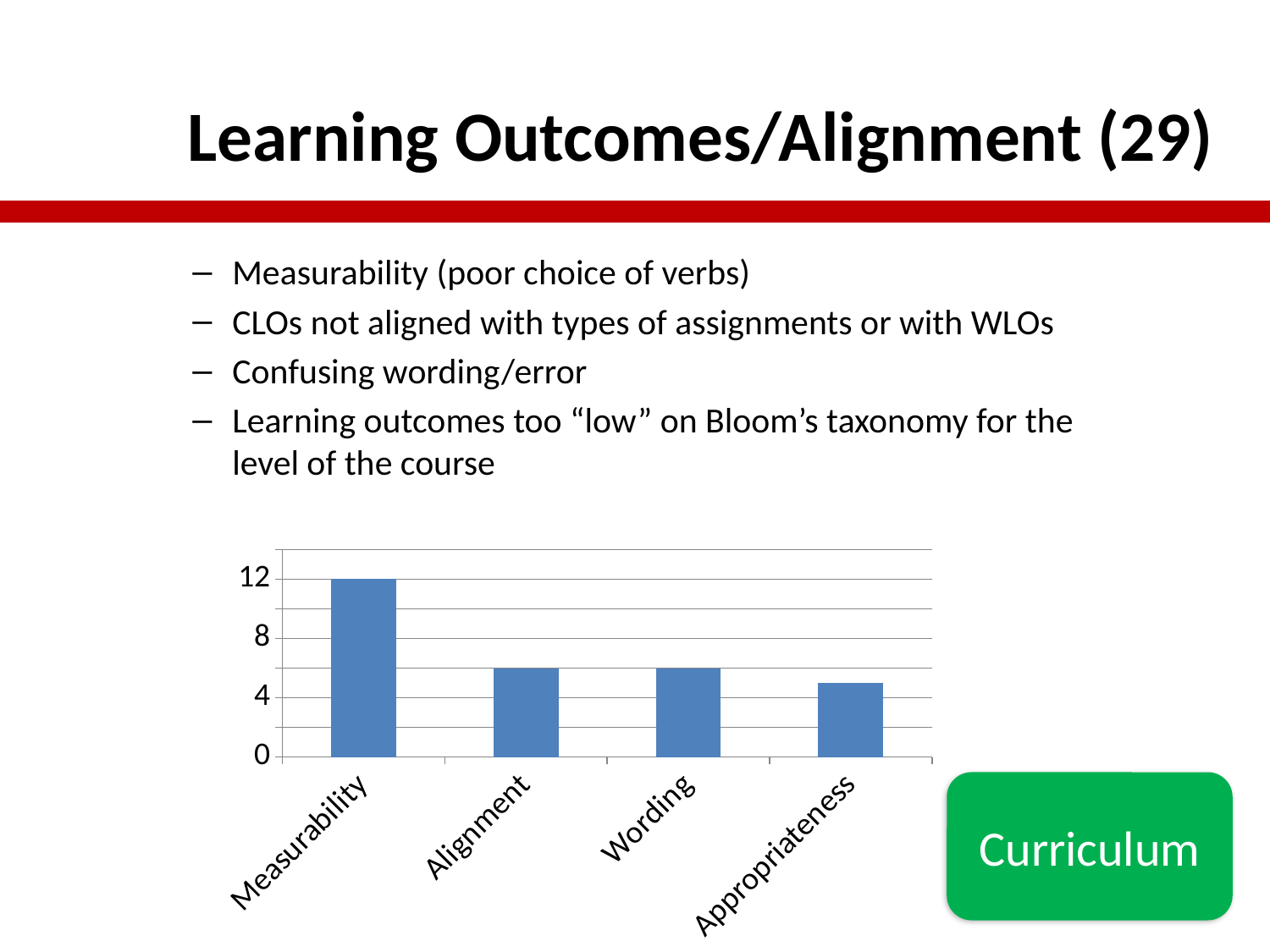
What is the highest tick value shown on the vertical axis of the bar chart? 12 Is the value for Measurability greater or less than 8? greater Which category has the highest value in the bar chart? Measurability Is the value for Appropriateness greater or less than 8? less Which is larger, the value for Alignment or the value for Appropriateness? Alignment Which is larger, the value for Measurability or the value for Wording? Measurability Is the value for Wording greater or less than 4? greater What is the value for Measurability in the bar chart? 12 Which category has the lowest value in the bar chart? Appropriateness How many categories are plotted in the bar chart? 4 What kind of chart is shown on the slide? bar chart